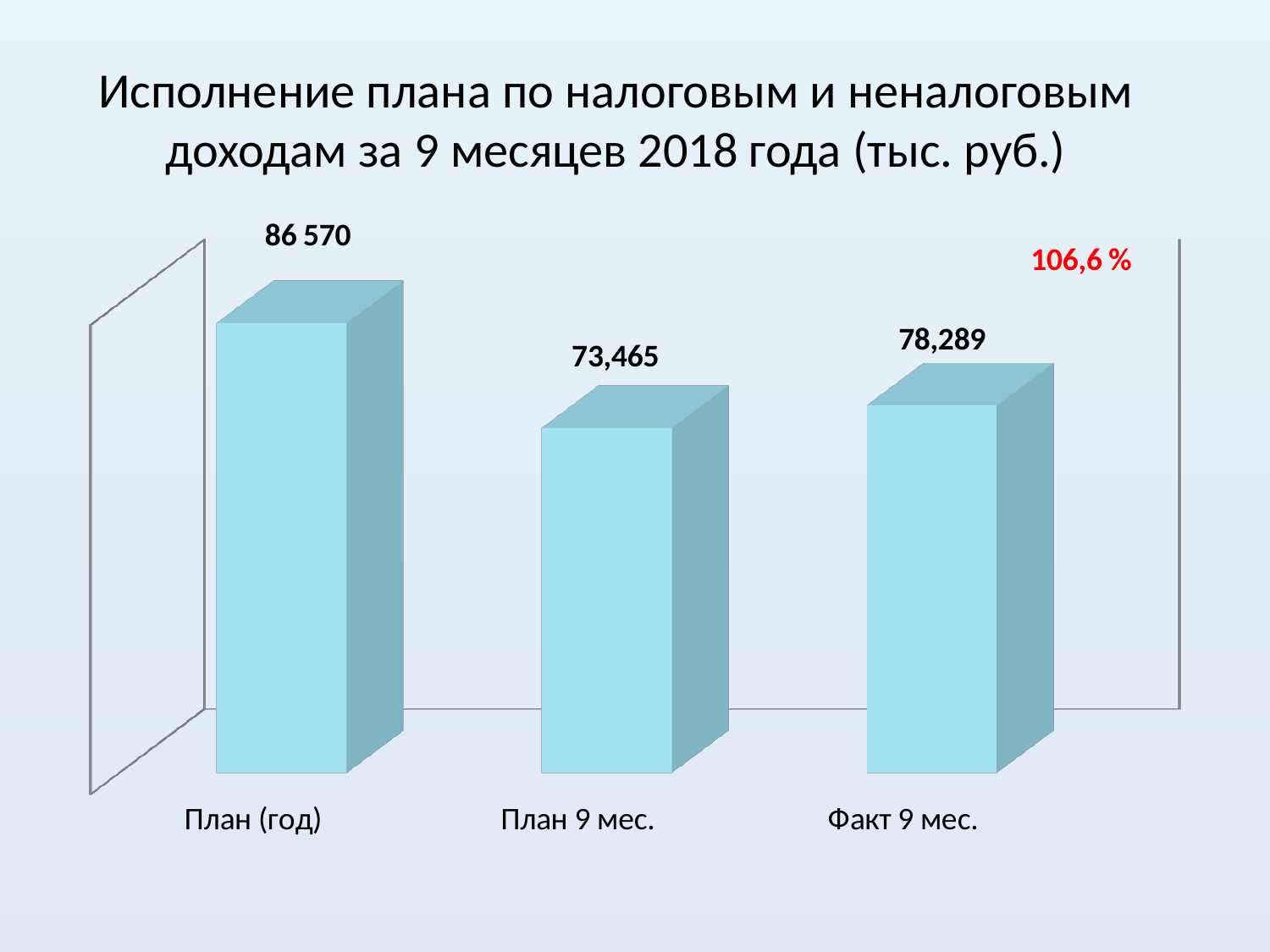
Which is larger, План (год) or Факт 9 мес.? План (год) Which category has the lowest value? План 9 мес. How many categories are shown in the chart? 3 What is the value for Факт 9 мес.? 78,289 What unit of measurement is given in the chart title? тыс. руб. What percentage is shown in red on the chart? 106,6 % What is the value for План 9 мес.? 73,465 What is the difference between Факт 9 мес. and План 9 мес.? 4,824 Which is larger, Факт 9 мес. or План 9 мес.? Факт 9 мес. What kind of chart is shown on the slide? Bar chart Which category has the highest value? План (год) What is the value for План (год)? 86 570